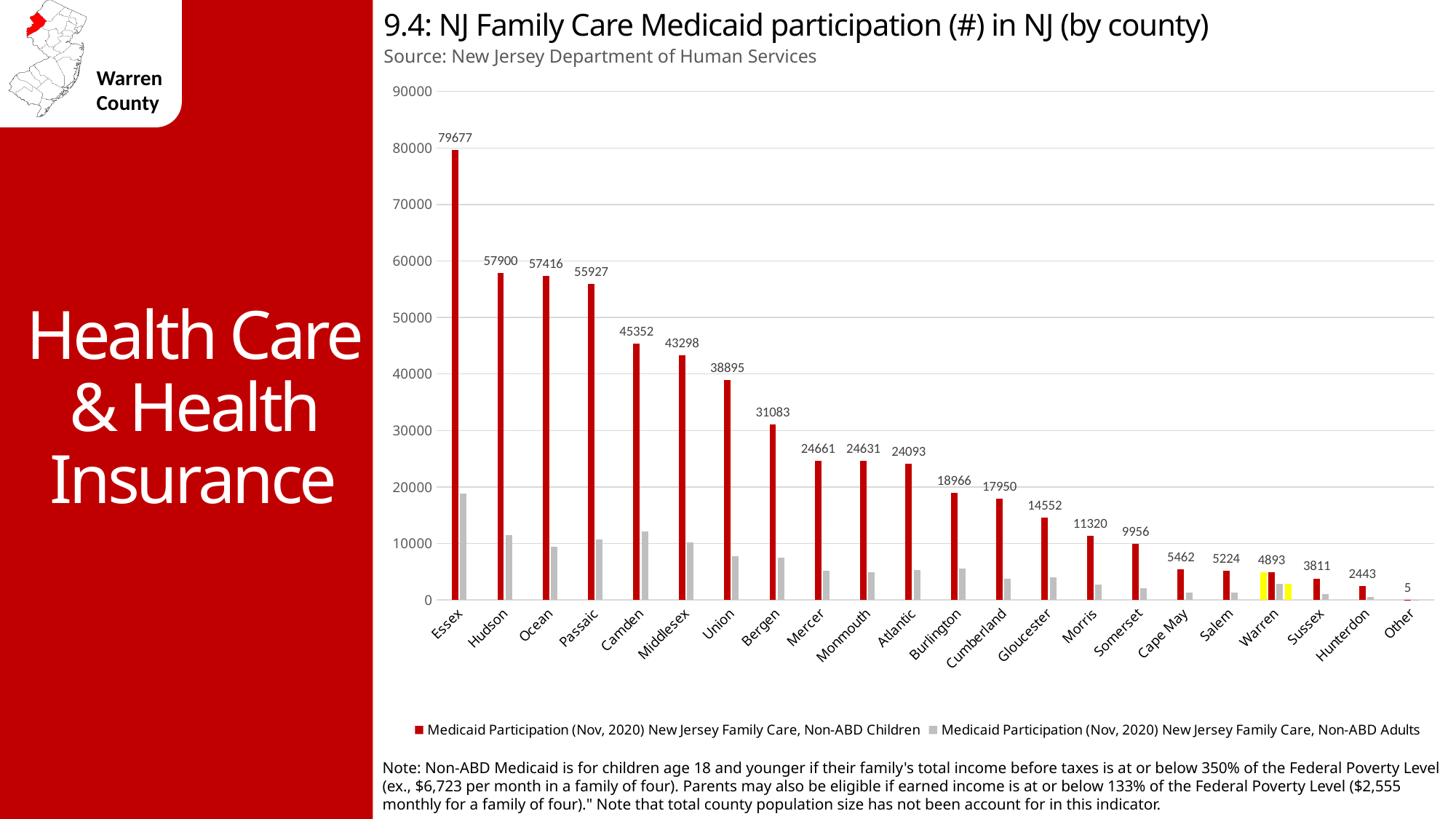
What is the difference between the Non-ABD Children values for Hudson and Ocean? 484 What is the Non-ABD Children Medicaid participation value for Warren? 4893 Do the Non-ABD Children values rise or fall moving from left to right along the x axis? fall What kind of chart is shown on the slide? bar chart Which category has the lowest Non-ABD Children Medicaid participation? Other Which has a larger Non-ABD Children value, Camden or Middlesex? Camden What is the Non-ABD Children Medicaid participation value for Hunterdon? 2443 Which county has the highest Non-ABD Children Medicaid participation? Essex How many series does the legend list? 2 How many categories are shown on the x axis? 22 What is the Non-ABD Children Medicaid participation value for Essex? 79677 Is the Non-ABD Adults value for Essex greater or less than 10000? greater